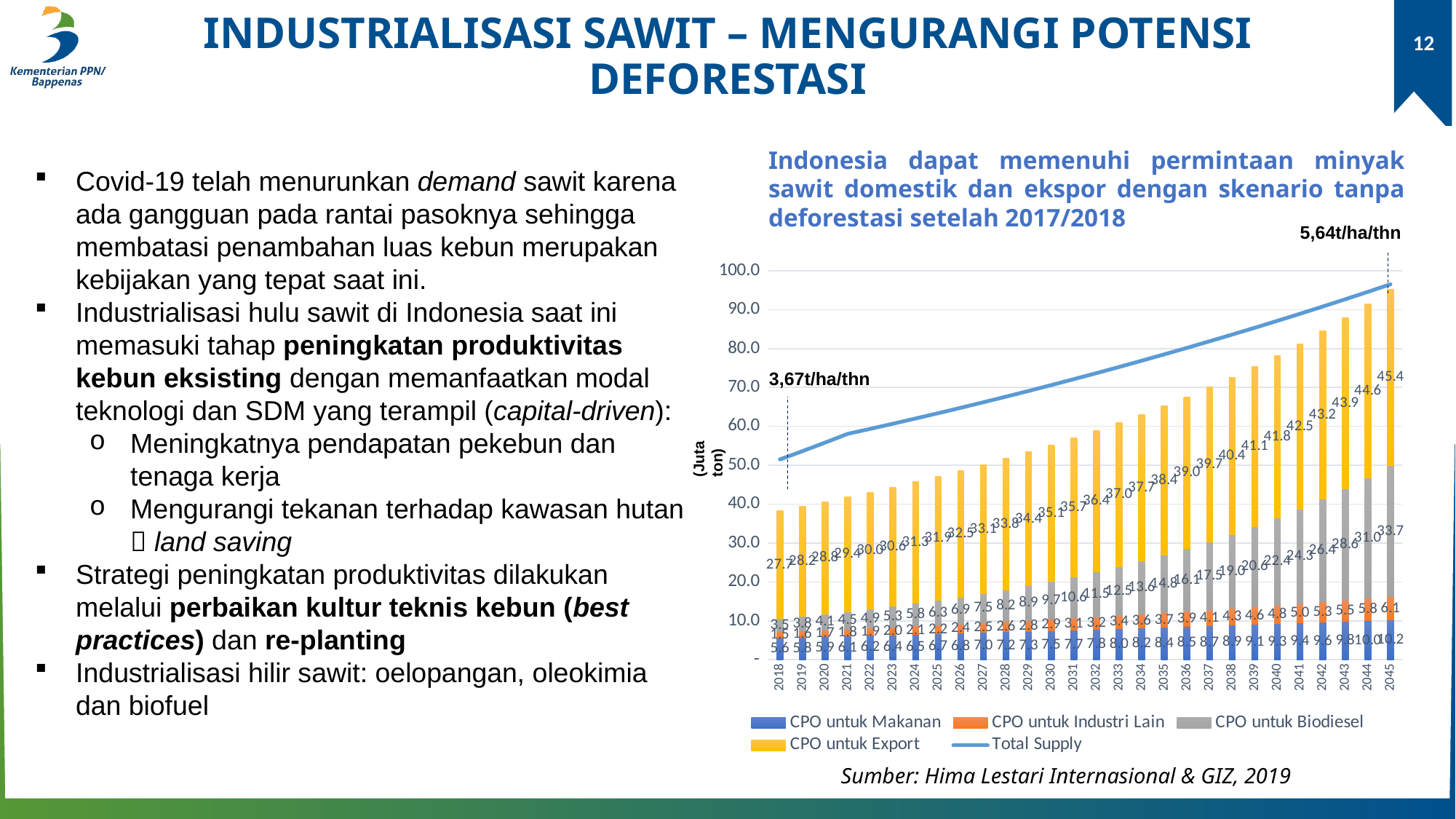
What is the value of CPO untuk Biodiesel in 2045? 33.7 Is the Total Supply value for 2018 greater or less than 60.0? less What is the value of CPO untuk Export in 2018? 27.7 What productivity figure is annotated at the 2045 end of the Total Supply line? 5,64t/ha/thn What is the difference between CPO untuk Export in 2045 and in 2018? 17.7 Does the Total Supply line rise or fall from 2018 to 2045? rise How many years are shown along the x axis of the chart? 28 What kind of chart is shown on the slide? combination bar and line chart (stacked bars with a line) How many series does the chart legend list? 5 Is the Total Supply value for 2045 greater or less than 90.0? greater What is the value of CPO untuk Export in 2045? 45.4 In 2045, which is larger: CPO untuk Export or CPO untuk Biodiesel? CPO untuk Export